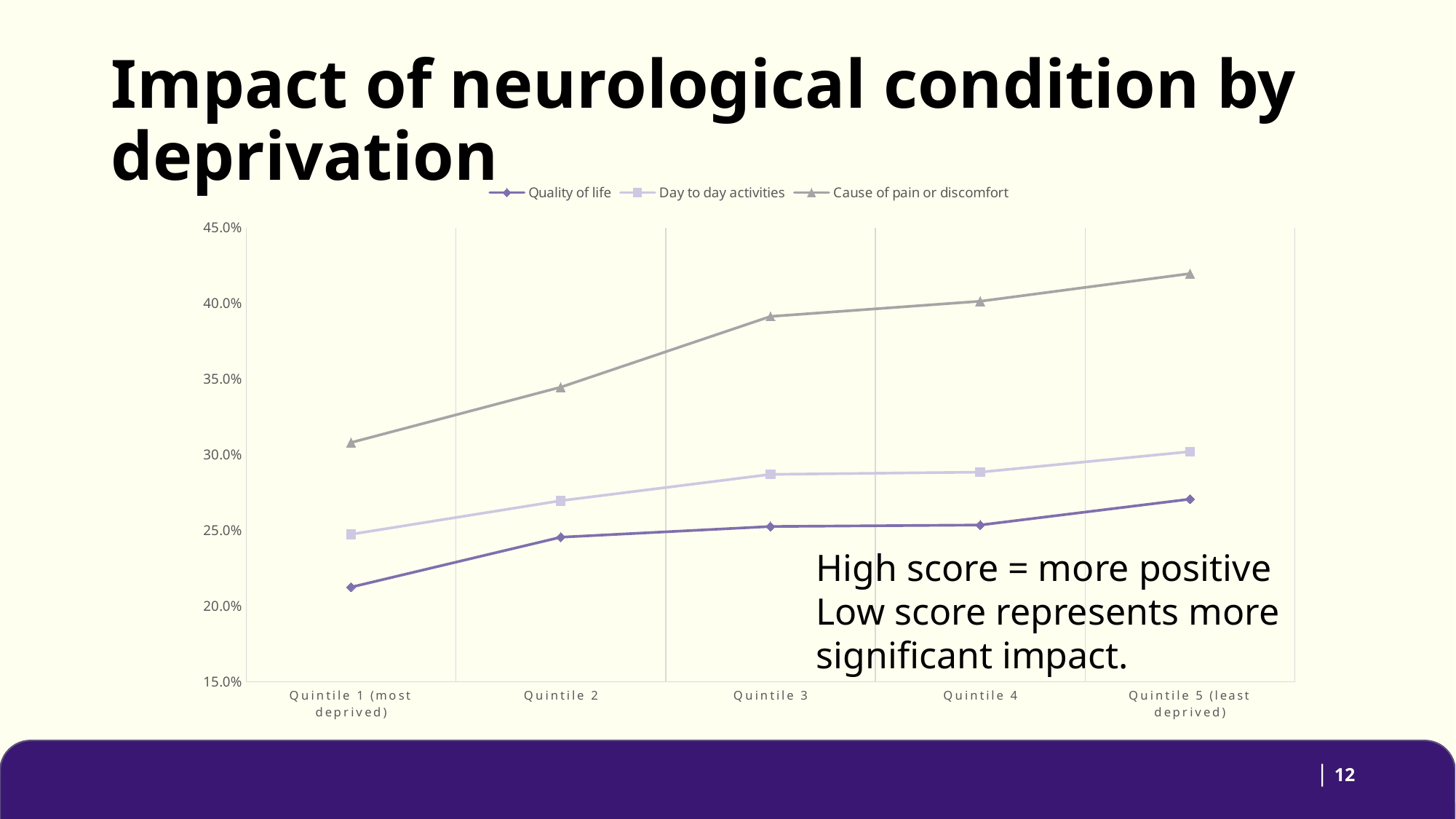
For the Quality of life series, which quintile has the lowest value? Quintile 1 (most deprived) Which series is plotted with the lowest values across all quintiles? Quality of life Is the value for Day to day activities at Quintile 3 greater or less than 30.0%? less What kind of chart is shown on the slide? Line chart For the Cause of pain or discomfort series, which quintile has the highest value? Quintile 5 (least deprived) Is the value for Cause of pain or discomfort at Quintile 5 (least deprived) greater or less than 40.0%? greater Do the values for Cause of pain or discomfort rise or fall from Quintile 1 to Quintile 5? Rise How many series does the legend list? 3 How many quintile categories are shown on the x axis? 5 Which series is plotted with the highest values across all quintiles? Cause of pain or discomfort At Quintile 2, which is larger: Cause of pain or discomfort or Day to day activities? Cause of pain or discomfort Is the value for Quality of life at Quintile 1 (most deprived) greater or less than 25.0%? less